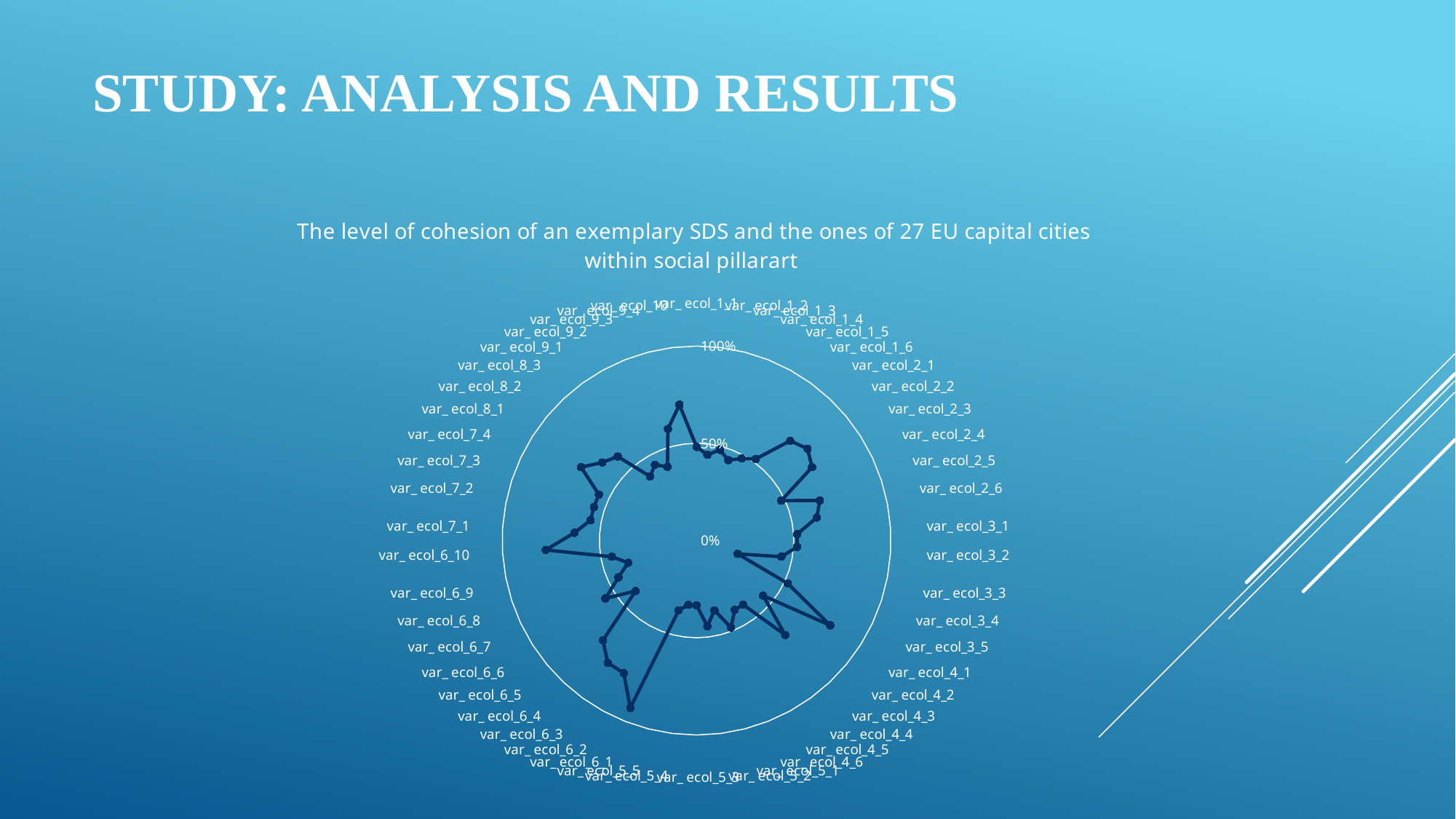
Is the value for var_ecol_3_4 greater or less than 50%? less Is the value for var_ecol_2_2 greater or less than 50%? greater Is the value for var_ecol_5_2 greater or less than 50%? less What is the title of the chart? The level of cohesion of an exemplary SDS and the ones of 27 EU capital cities within social pillarart What kind of chart is shown on the slide? Radar chart What percentage values are marked on the chart's radial axis? 0%, 50%, 100%